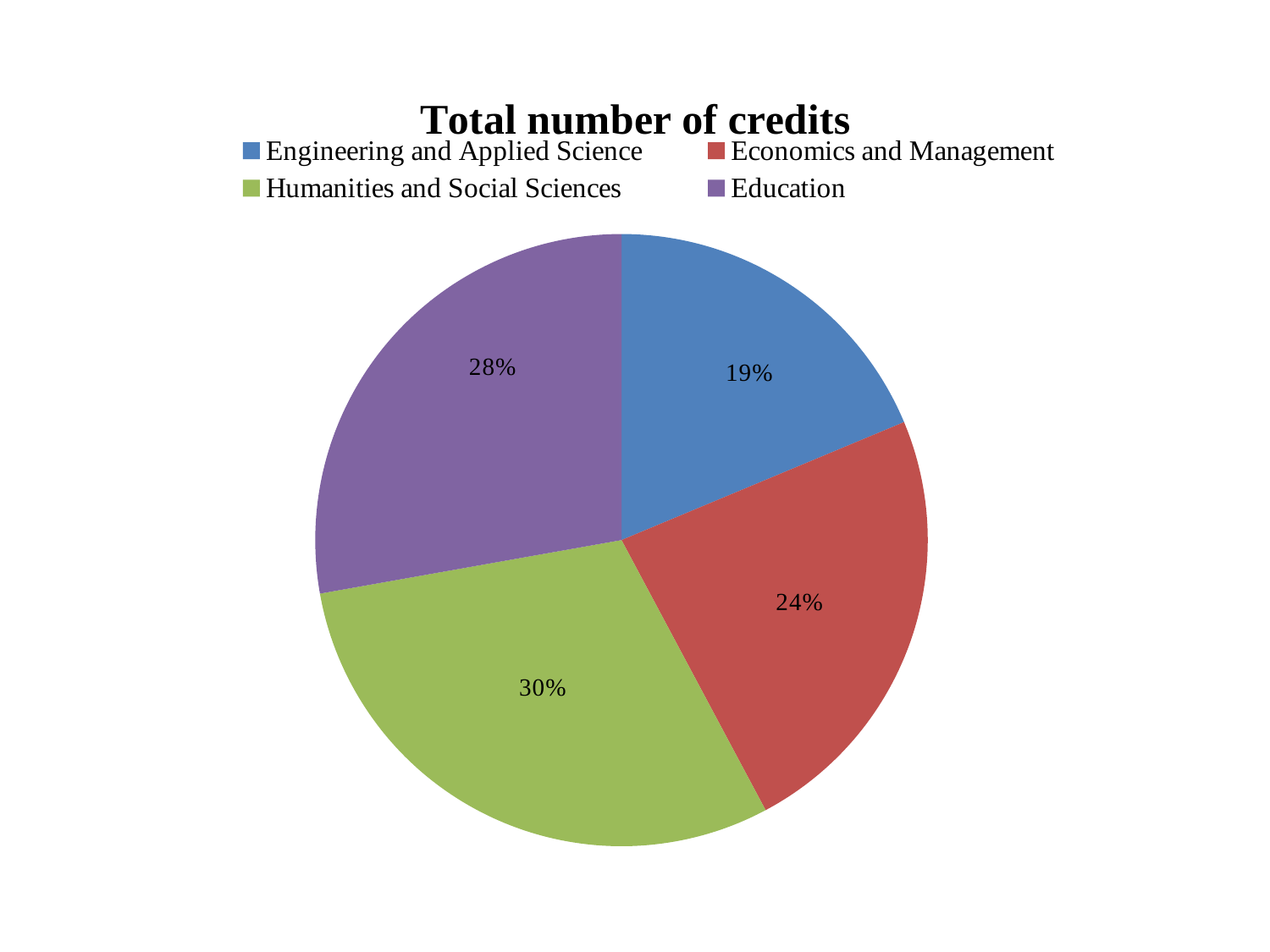
What is the difference in percentage points between Humanities and Social Sciences and Engineering and Applied Science? 11 What is the title of the chart? Total number of credits What share of the pie does Humanities and Social Sciences have? 30% How many categories does the pie chart show? 4 What share of the pie does Economics and Management have? 24% Which is larger, the share for Education or the share for Economics and Management? Education Which category has the smallest slice of the pie? Engineering and Applied Science What share of the pie does Engineering and Applied Science have? 19% Which colour represents Education in the legend? purple Which category has the largest slice of the pie? Humanities and Social Sciences What kind of chart is shown on the slide? pie chart